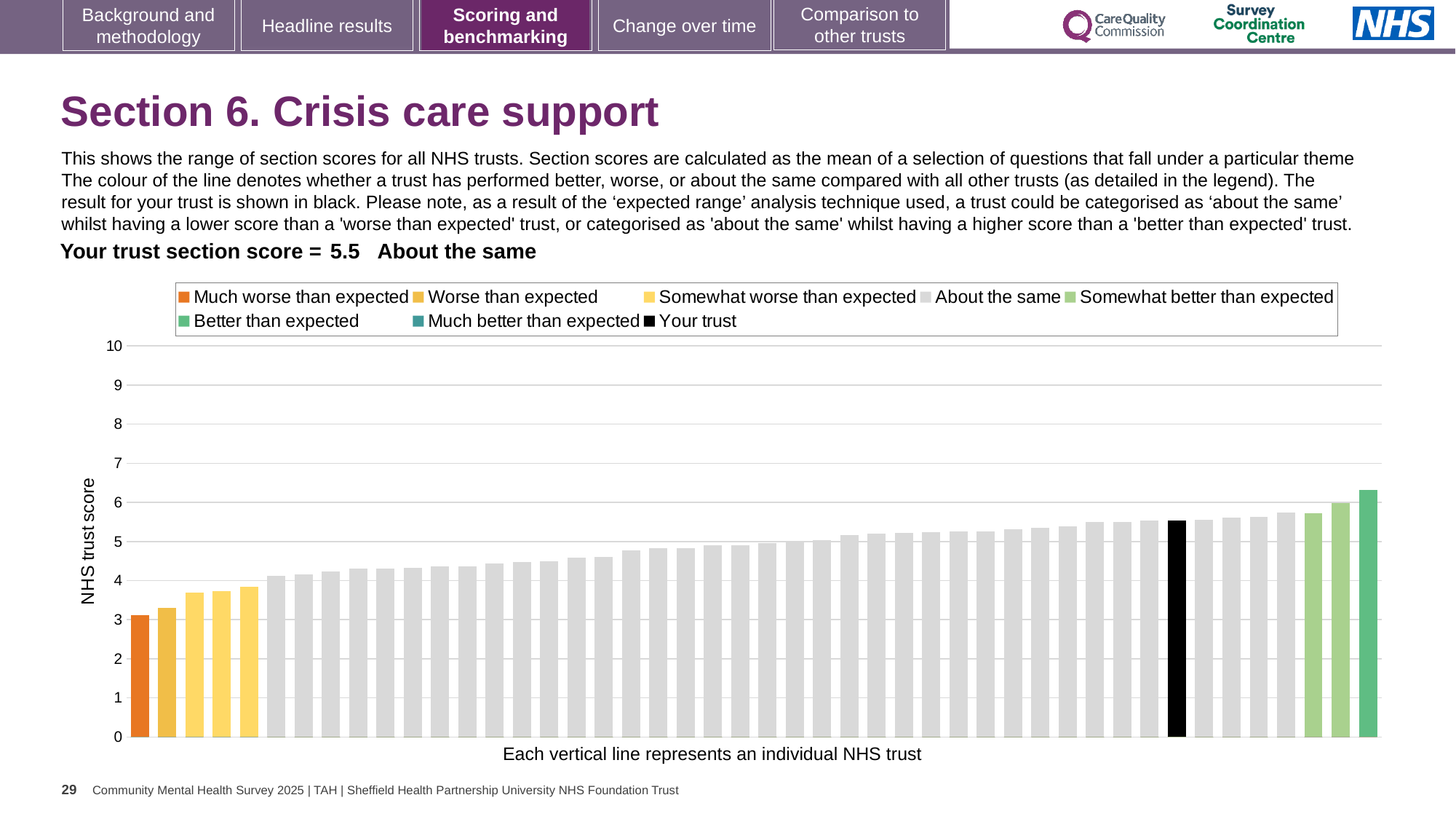
Which legend category does the lowest bar on the chart belong to? Much worse than expected How many entries does the chart legend list? 8 What is the section score for your trust? 5.5 Which legend category does the highest bar on the chart belong to? Better than expected Is the value of the lowest bar (the orange 'Much worse than expected' trust) greater or less than 4? less Is the value of the highest bar on the chart greater or less than 6? greater Is the value for your trust (the black bar) greater or less than 5? greater What is the label on the vertical axis of the chart? NHS trust score Which category is your trust placed in for this section? About the same What type of chart is shown on the slide? bar chart Do the trust scores rise or fall moving from left to right along the x axis? rise Is the orange 'Much worse than expected' bar higher or lower than the black 'Your trust' bar? lower